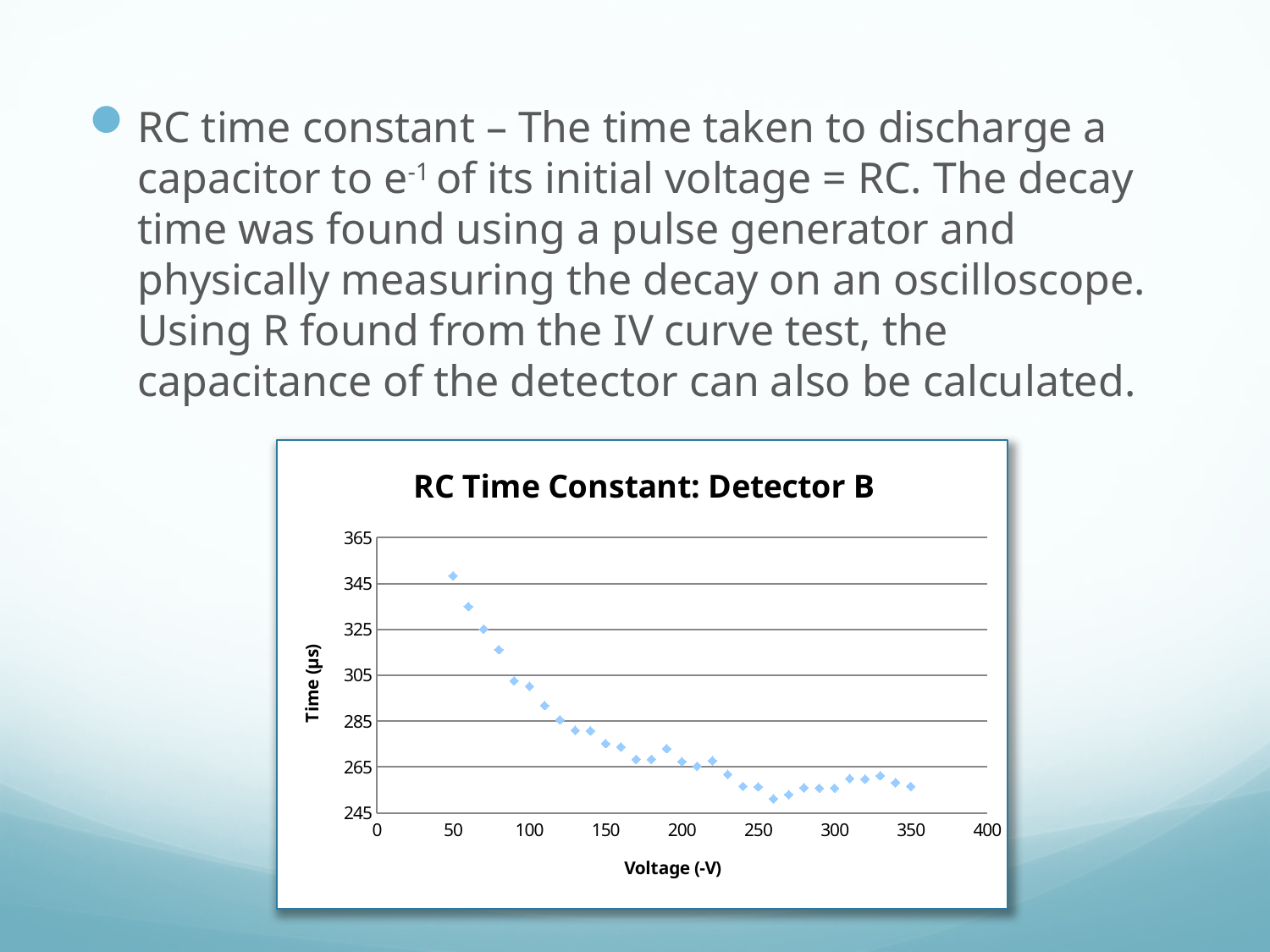
Is the time value at 350 V greater or less than 265? less Which has the larger time value, 50 V or 350 V? 50 V Which has the larger time value, 100 V or 300 V? 100 V Is the time value at 100 V greater or less than 285? greater Overall, does the time rise or fall as the voltage increases along the x axis? fall At which voltage is the time value highest? 50 What is the title of the chart? RC Time Constant: Detector B What is the label of the y axis? Time (μs) What kind of chart is shown on the slide? scatter chart At which voltage is the time value lowest? 260 Is the time value at 260 V greater or less than 265? less